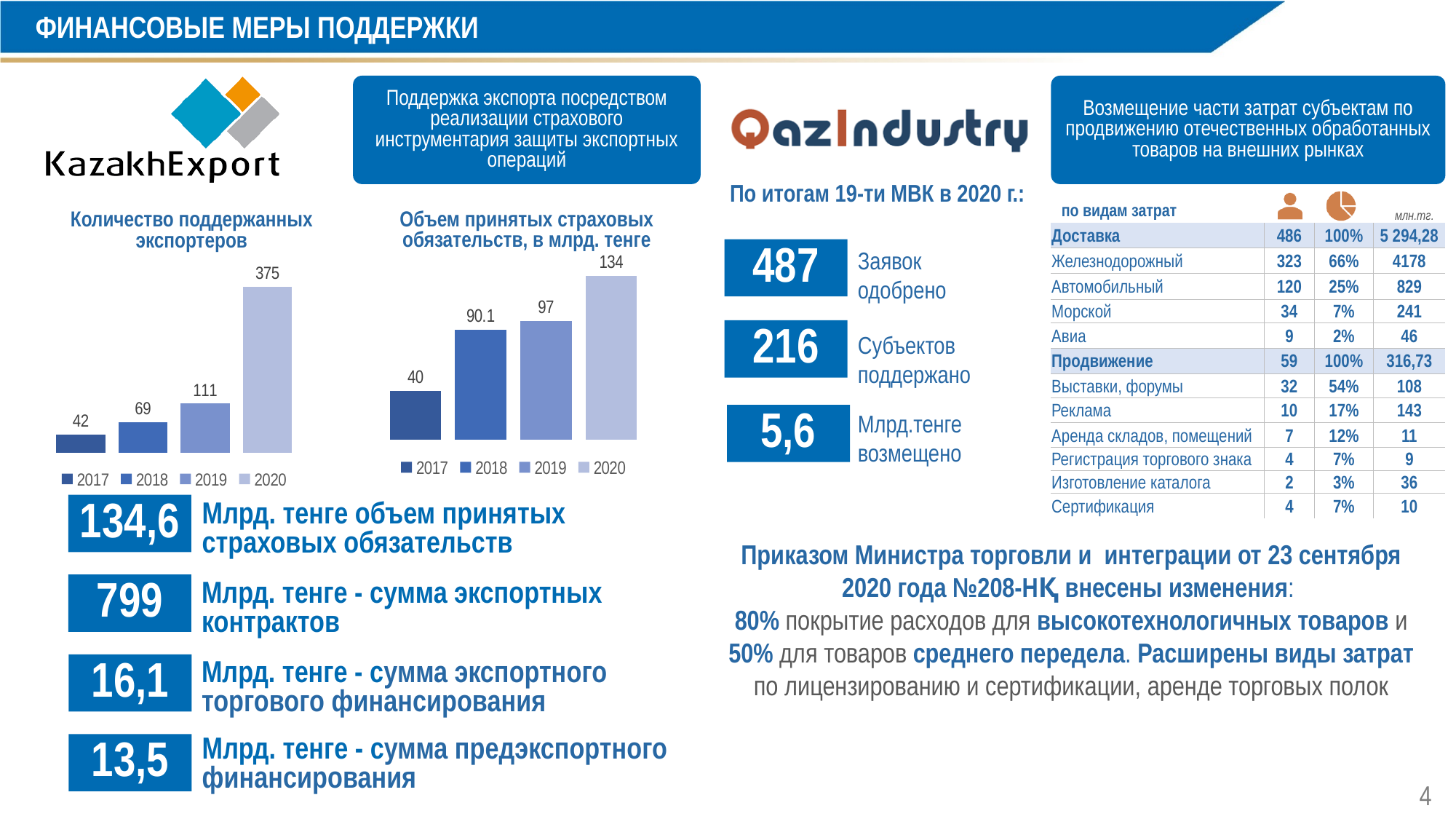
In the chart 'Объем принятых страховых обязательств, в млрд. тенге', what is the value for 2018? 90.1 In the chart 'Объем принятых страховых обязательств, в млрд. тенге', which is larger, the value for 2019 or the value for 2017? 2019 In the chart 'Количество поддержанных экспортеров', what is the value for 2020? 375 In the chart 'Количество поддержанных экспортеров', what is the value for 2017? 42 How many bars are plotted in the chart 'Количество поддержанных экспортеров'? 4 In the chart 'Количество поддержанных экспортеров', what is the difference between the values for 2019 and 2018? 42 What kind of chart is 'Объем принятых страховых обязательств, в млрд. тенге'? bar chart In the chart 'Количество поддержанных экспортеров', which year has the highest value? 2020 In the chart 'Объем принятых страховых обязательств, в млрд. тенге', what is the value for 2020? 134 In the chart 'Объем принятых страховых обязательств, в млрд. тенге', do the values rise or fall from 2017 to 2020? rise In the chart 'Количество поддержанных экспортеров', which year has the lowest value? 2017 In the chart 'Объем принятых страховых обязательств, в млрд. тенге', what is the difference between the values for 2020 and 2019? 37